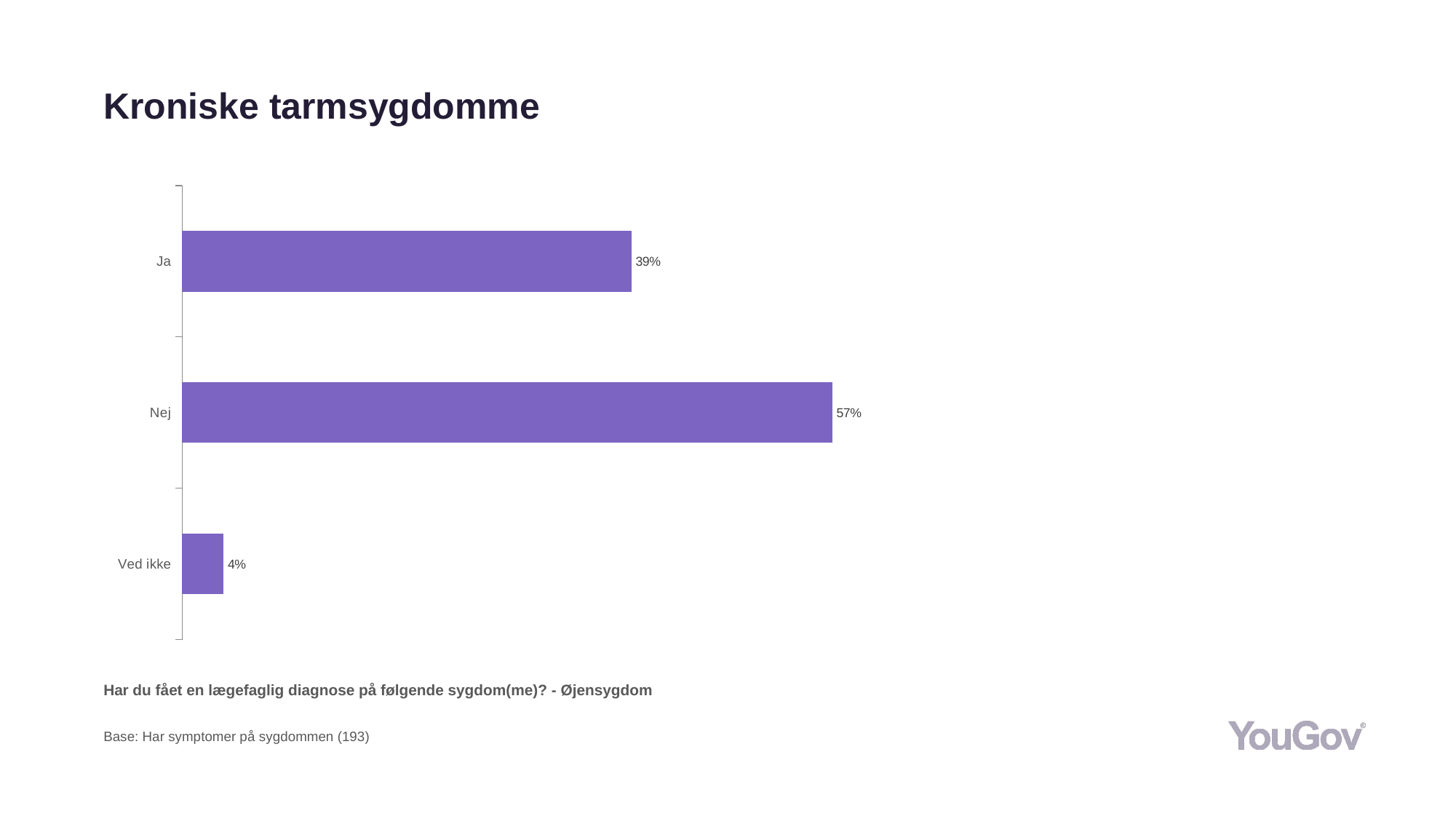
How many categories are shown in the chart? 3 What is the value for "Ved ikke"? 4% Which is larger, the value for "Ja" or the value for "Nej"? Nej What is the value for "Ja"? 39% What kind of chart is shown on the slide? Bar chart What is the title of the slide? Kroniske tarmsygdomme What colour are the bars in the chart? Purple What is the difference between the values for "Nej" and "Ja"? 18% What is the value for "Nej"? 57% What is the difference between the values for "Ja" and "Ved ikke"? 35% Which category has the highest value? Nej Which category has the lowest value? Ved ikke